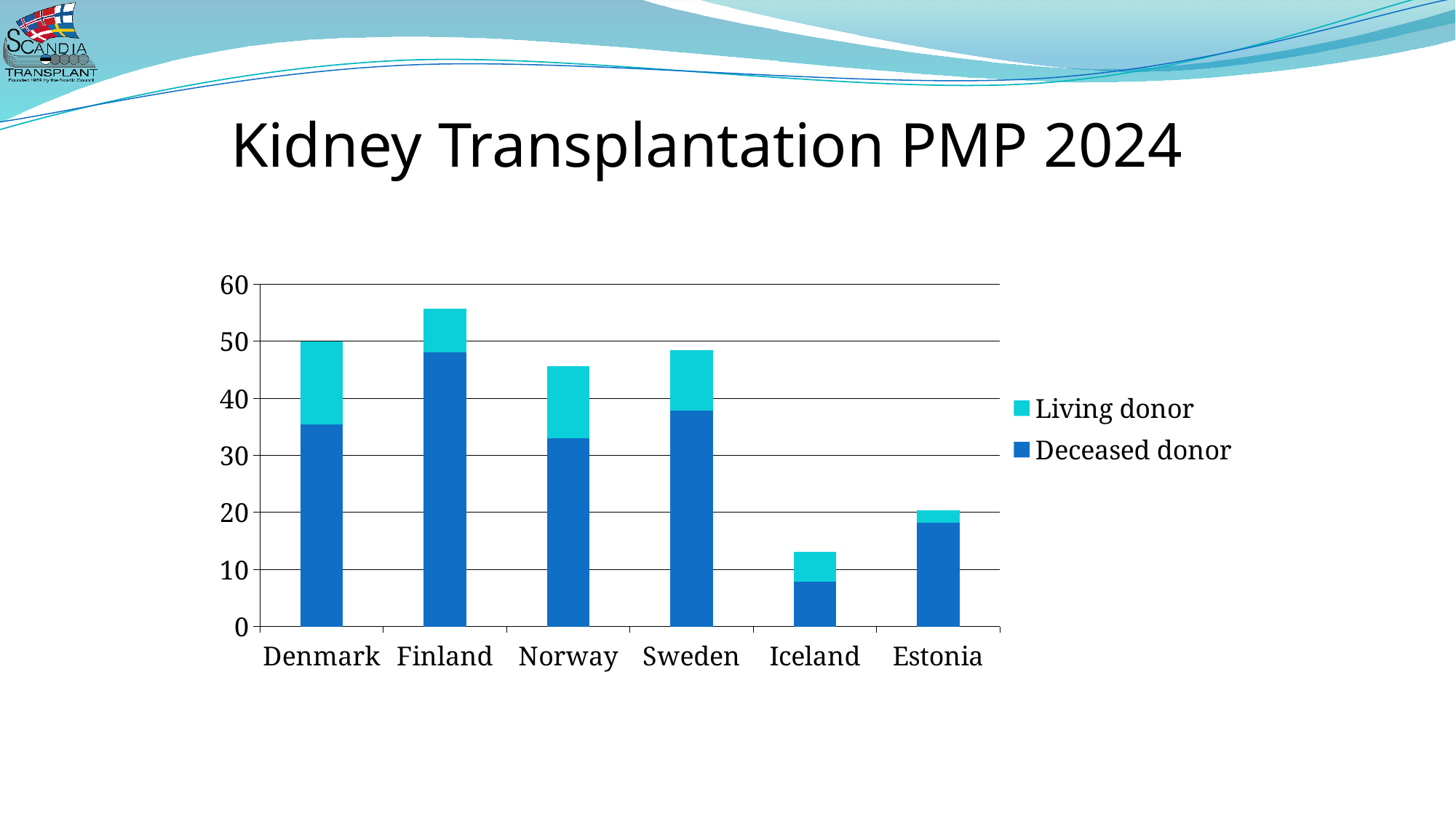
Which has the larger total bar, Denmark or Norway? Denmark How many countries are shown on the x axis of the chart? 6 What is the title of the slide containing the chart? Kidney Transplantation PMP 2024 Which country has the highest deceased donor value? Finland Which country has the lowest living donor value? Estonia How many series does the legend list? 2 Is the deceased donor value for Denmark greater or less than 30? greater Is the total bar for Iceland greater or less than 20? less What kind of chart is shown on the slide? Stacked bar chart Is the total bar for Finland greater or less than 50? greater Which country has the lowest total kidney transplantation PMP? Iceland Which country has the highest total kidney transplantation PMP? Finland